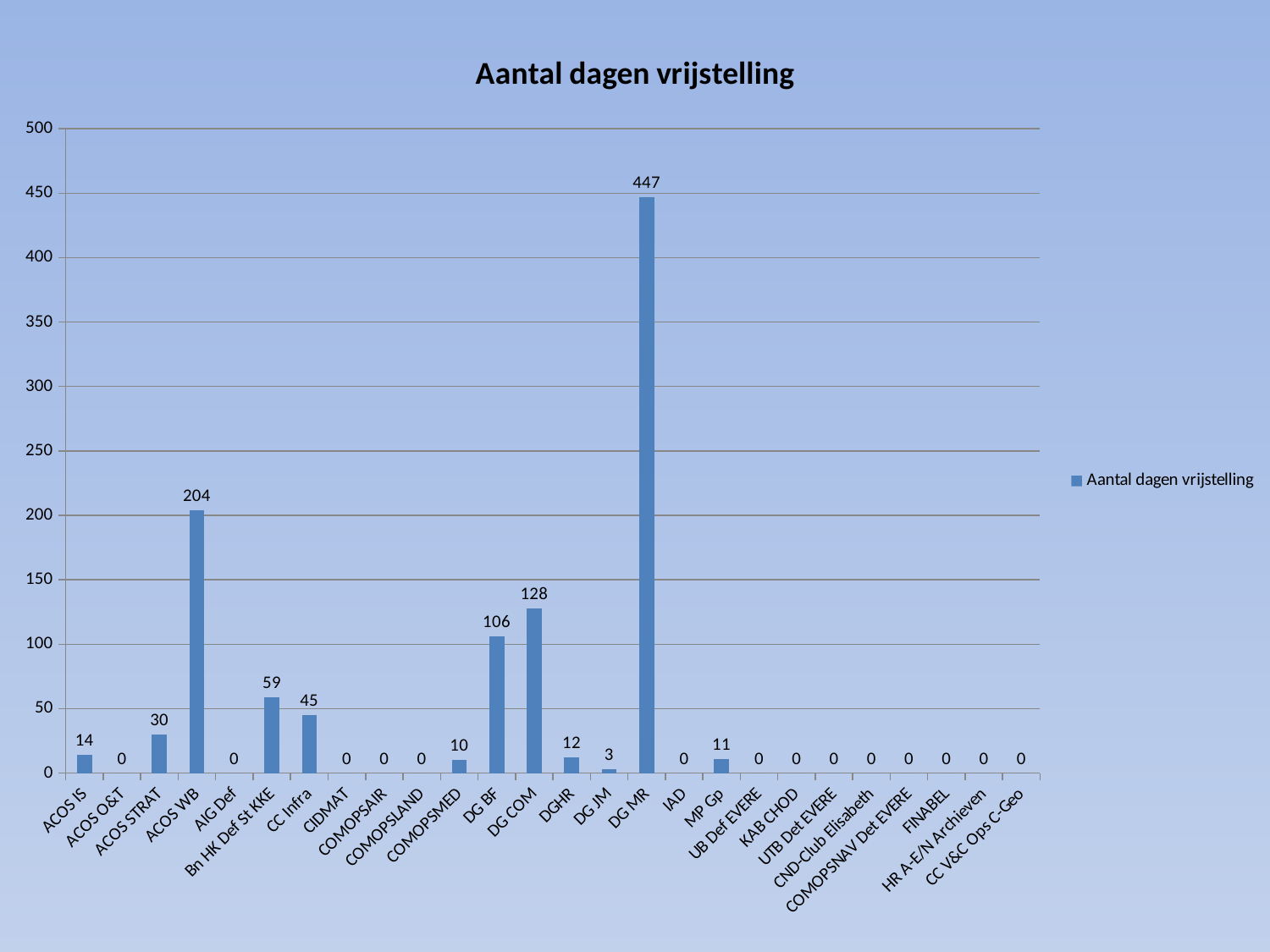
How many series does the legend list? 1 What kind of chart is shown on the slide? bar chart What is the value for Bn HK Def St KKE? 59 What is the value for DG MR? 447 Is the value for DG MR greater or less than 400? greater Which is larger, the value for CC Infra or the value for ACOS STRAT? CC Infra How many categories are shown on the x axis? 26 What is the value for MP Gp? 11 What is the value for ACOS WB? 204 What is the difference between the values for DG COM and DG BF? 22 What is the difference between the values for DG MR and ACOS WB? 243 Which category has the highest value? DG MR